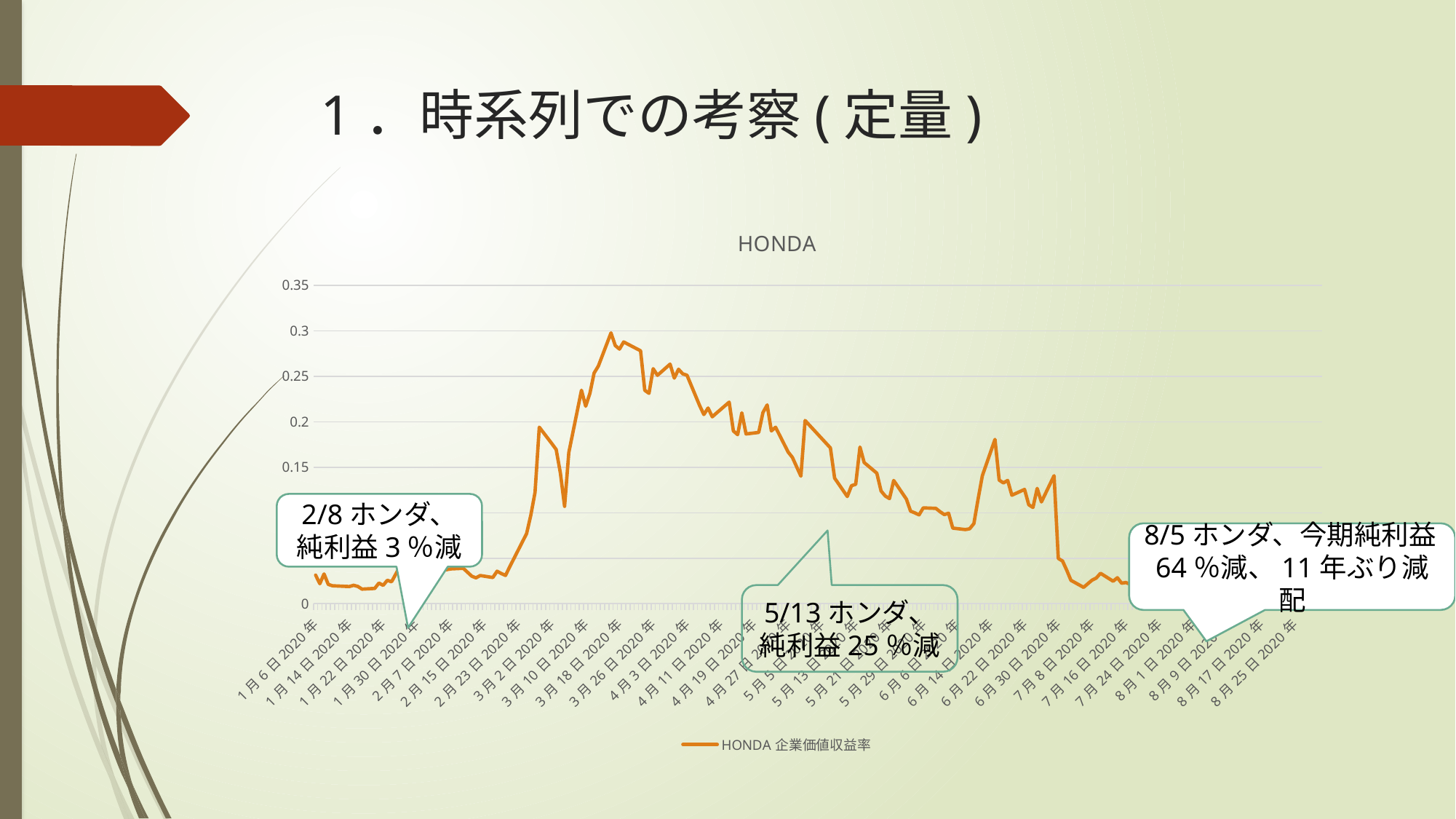
Is the value for 3月18日2020年 greater or less than 0.2? greater Is the value for 8月25日2020年 greater or less than 0.1? less What is the title of the chart? HONDA Is the value for 1月6日2020年 greater or less than 0.1? less Which is larger, the value for 3月18日2020年 or the value for 7月8日2020年? 3月18日2020年 How many series does the legend list? 1 Between 3月26日2020年 and 5月29日2020年, do the values generally rise or fall? fall What is the name of the series shown in the legend? HONDA 企業価値収益率 In which month does the line reach its highest value? 3月 (March) What kind of chart is shown on the slide? line chart